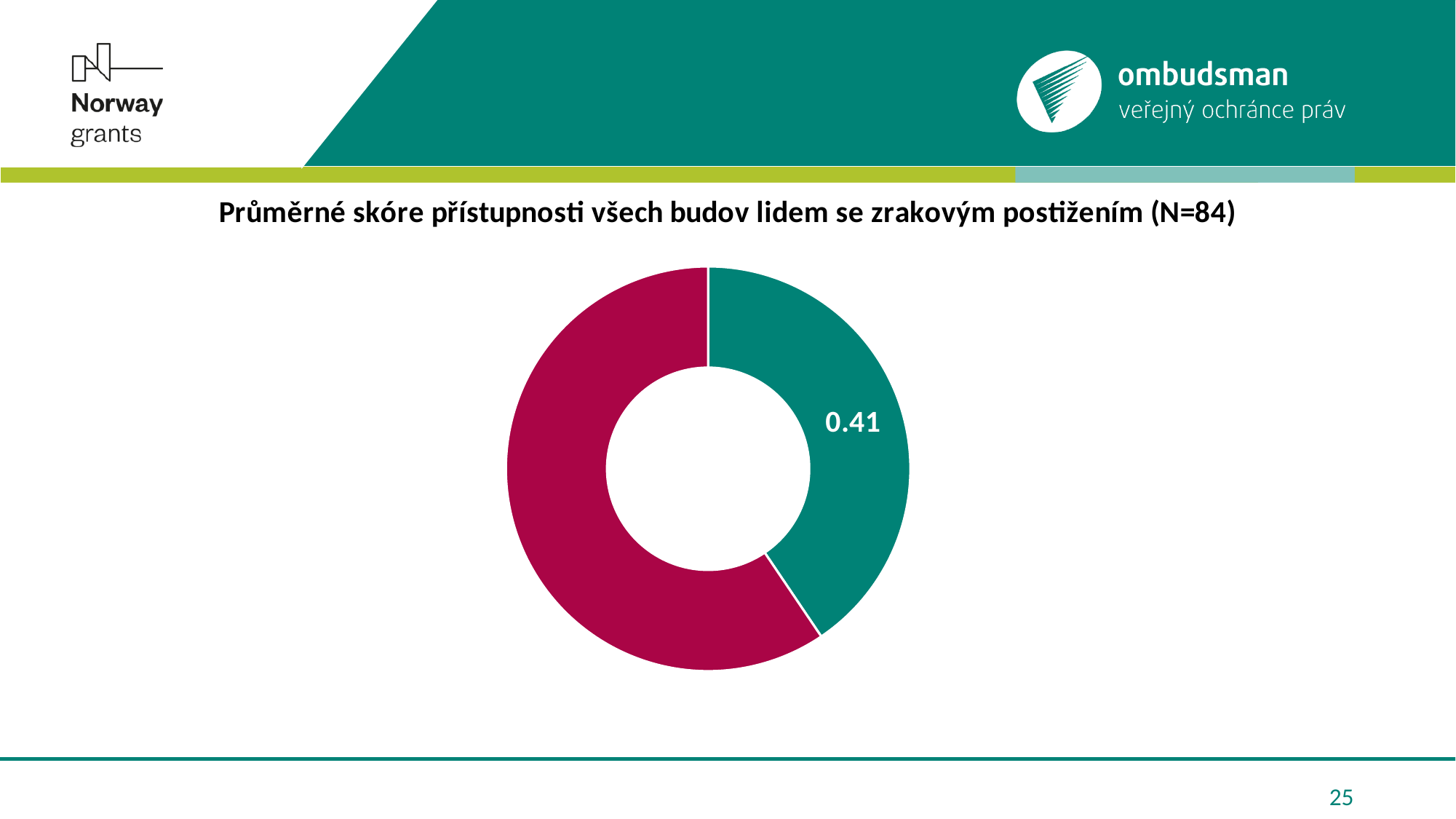
What is the title of the chart? Průměrné skóre přístupnosti všech budov lidem se zrakovým postižením (N=84) Which slice of the doughnut chart is larger, the teal one or the magenta one? The magenta one What value is printed on the teal slice of the doughnut chart? 0.41 What sample size (N) is stated in the chart title? 84 How many slices does the doughnut chart have? 2 Is the labelled slice of the doughnut chart smaller than half of the whole ring? Yes What kind of chart is shown on the slide? Doughnut (pie) chart What colour is the slice labelled 0.41? Teal (green)